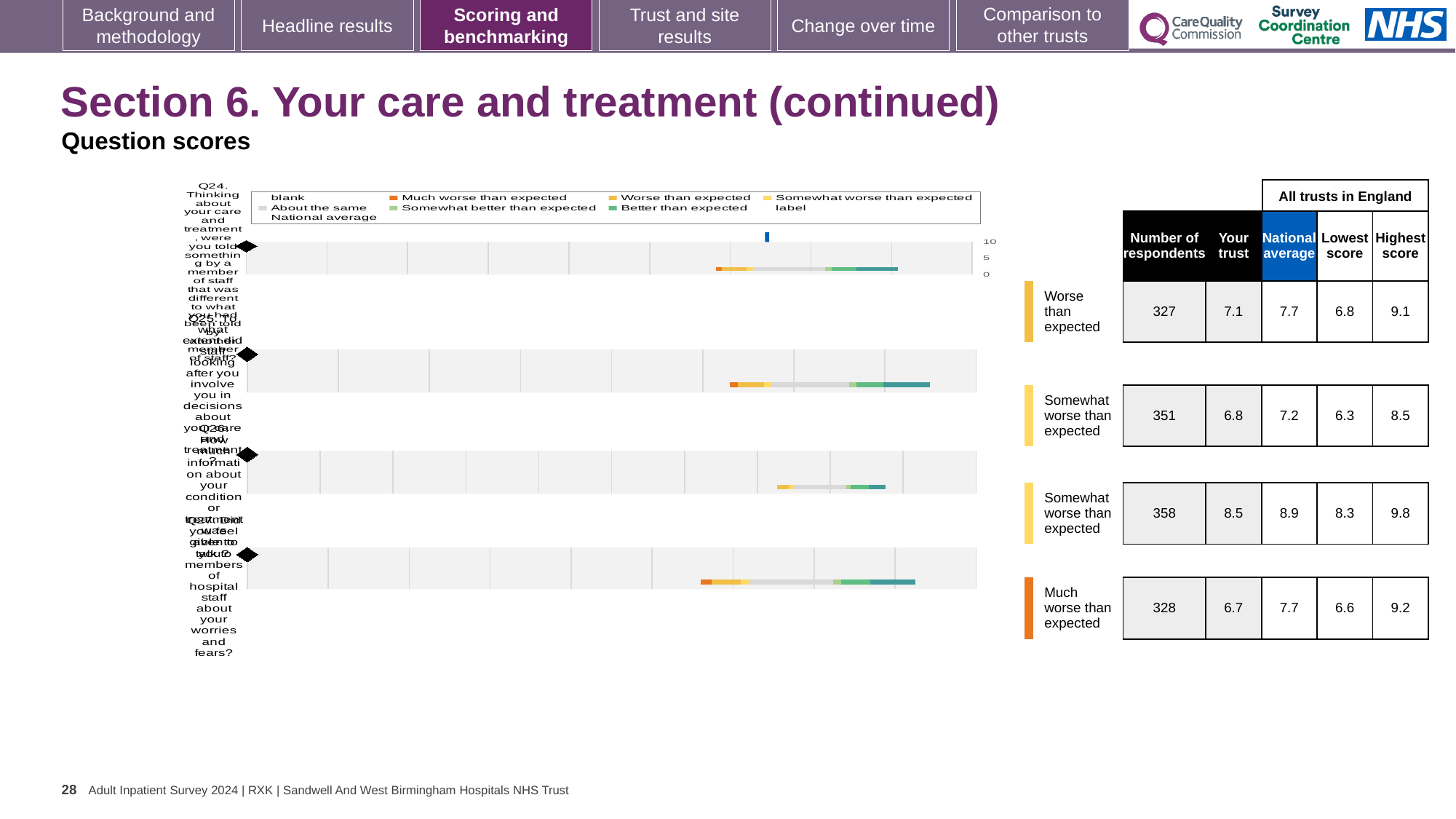
In the table beside the charts, which row has the highest 'Your trust' score? the third row (8.5) In the table beside the charts, what is the number of respondents in the last row (Much worse than expected)? 328 How many entries does the legend above the charts list? 9 In the table beside the charts, is the trust score in the second row (6.8) larger or smaller than the national average (7.2)? smaller What kind of chart is used for the question scores on this slide? bar chart What is the highest tick value shown on the horizontal axis of the top chart? 10 In the table beside the charts, which row has the lowest 'Your trust' score? the last row (6.7) In the legend, what colour represents 'Much worse than expected'? orange In the table beside the charts, what is the difference between the national average and the trust score in the last row (Much worse than expected)? 1.0 In the table beside the charts, what is the national average in the third row (Somewhat worse than expected, 358 respondents)? 8.9 In the table beside the charts, what is the 'Your trust' score in the first row (Worse than expected)? 7.1 How many question charts are shown on the slide? 4